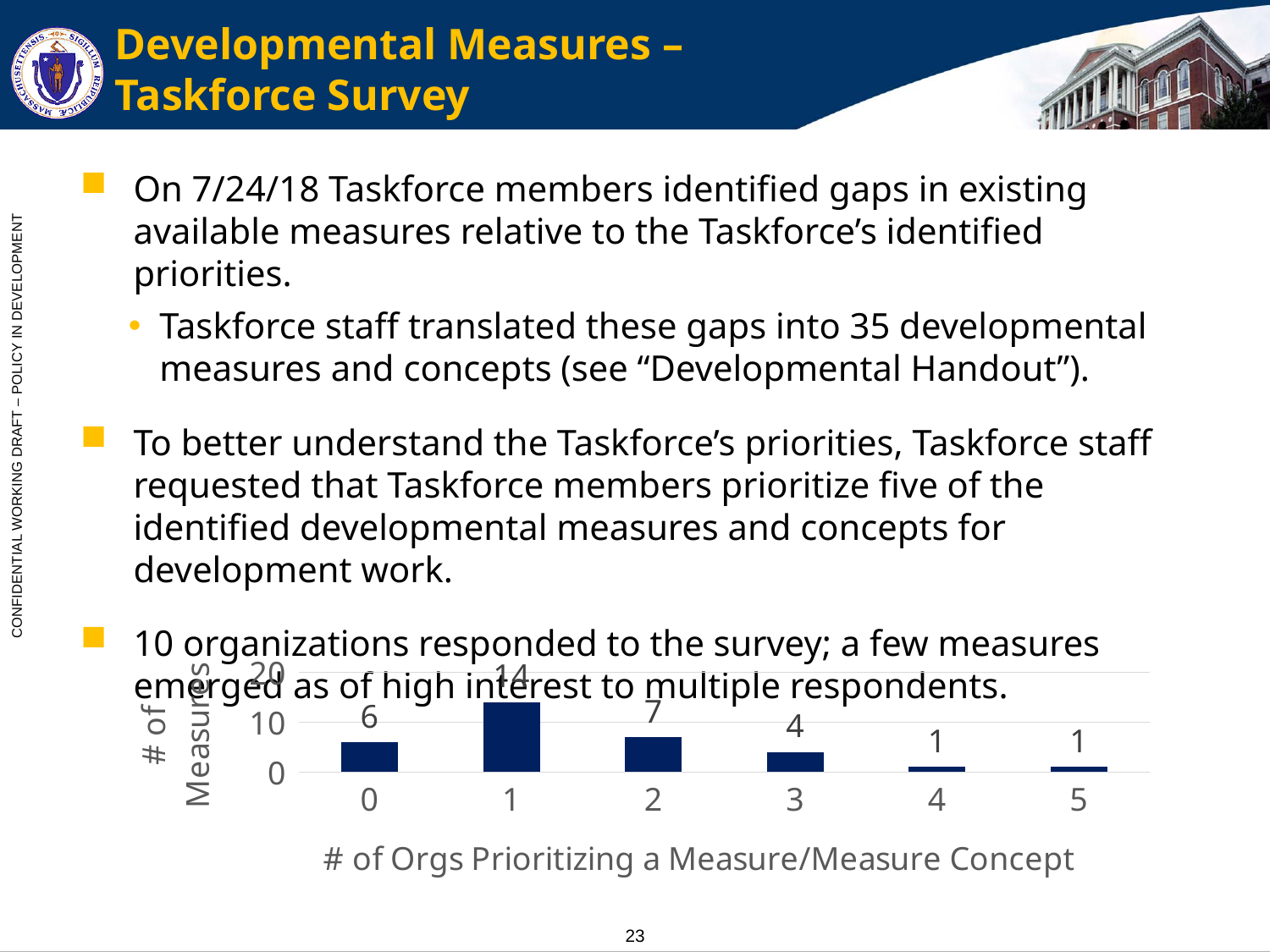
What kind of chart is shown on the slide? bar chart What is the y-axis title of the chart? # of Measures How many measures were prioritized by 3 organizations? 4 Is the value for 1 organization greater or less than 10? greater What is the difference between the number of measures prioritized by 1 organization and by 2 organizations? 7 How many measures were prioritized by 1 organization? 14 Which is larger: the number of measures prioritized by 0 organizations or by 2 organizations? 2 organizations How many measures were prioritized by 0 organizations? 6 Which number of prioritizing organizations has the highest number of measures? 1 How many measures were prioritized by 5 organizations? 1 What is the x-axis title of the chart? # of Orgs Prioritizing a Measure/Measure Concept How many categories are shown on the x axis of the chart? 6